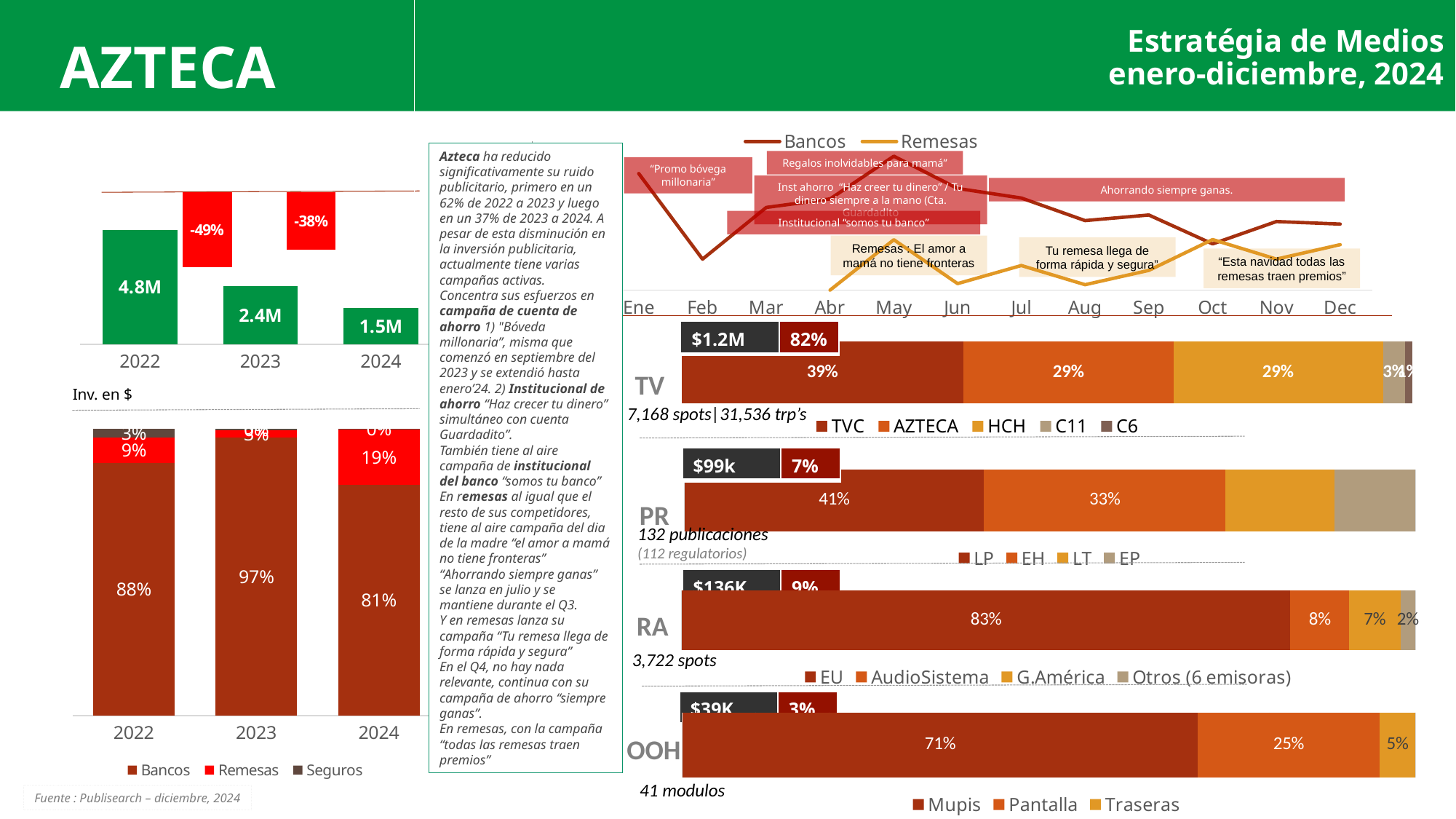
In the PR stacked bar on the right, what is the share for LP? 41% In the 'Inv. en $' bar chart on the left, which year has the highest investment? 2022 In the 'Inv. en $' bar chart on the left, what percentage change is shown for 2023? -49% In the 'Inv. en $' bar chart on the left, do the values rise or fall from 2022 to 2024? fall In the 'Inv. en $' bar chart on the left, what is the value for 2022? 4.8M In the RA stacked bar on the right, which station has the largest share? EU In the TV stacked bar on the right, what is the share for TVC? 39% In the OOH stacked bar on the right, what is the difference between the Mupis and Pantalla shares? 46% In the 'Inv. en $' bar chart on the left, what is the value for 2024? 1.5M In the stacked bar chart at the bottom left, what is the share for Bancos in 2023? 97% In the stacked bar chart at the bottom left, what is the share for Remesas in 2024? 19% How many series does the legend of the stacked bar chart at the bottom left list? 3